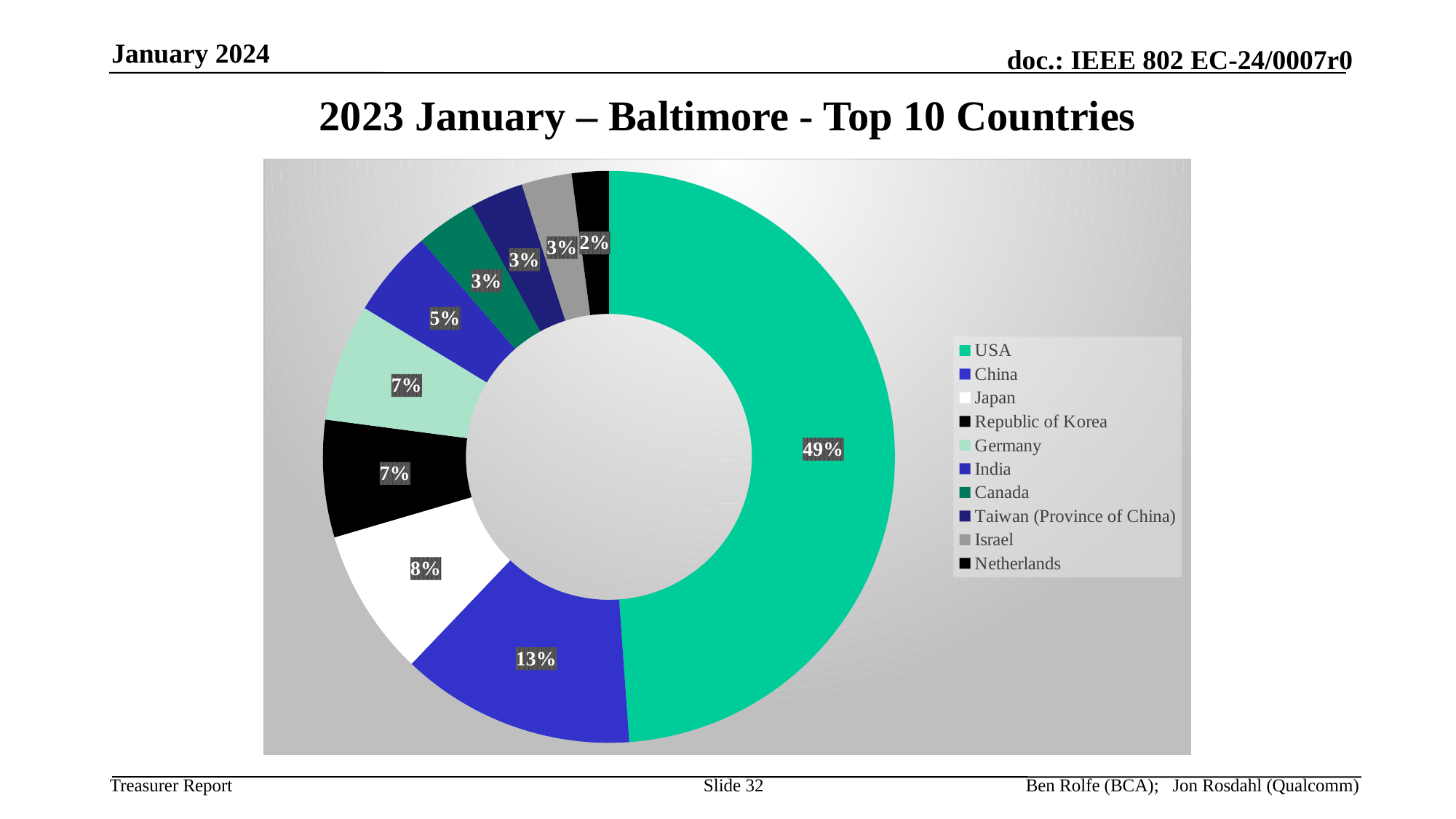
What is the title of the slide containing the chart? 2023 January – Baltimore - Top 10 Countries What percentage is shown for China? 13% Which country has the smallest share in the chart? Netherlands What is the difference in percentage points between USA and China? 36 What kind of chart is shown on the slide? Doughnut (pie) chart What percentage is shown for Netherlands? 2% What percentage is shown for Germany? 7% Which has a larger share, Japan or India? Japan Which country has the largest share in the chart? USA What share of the chart does USA account for? 49% How many countries are listed in the chart legend? 10 What percentage is shown for Japan? 8%